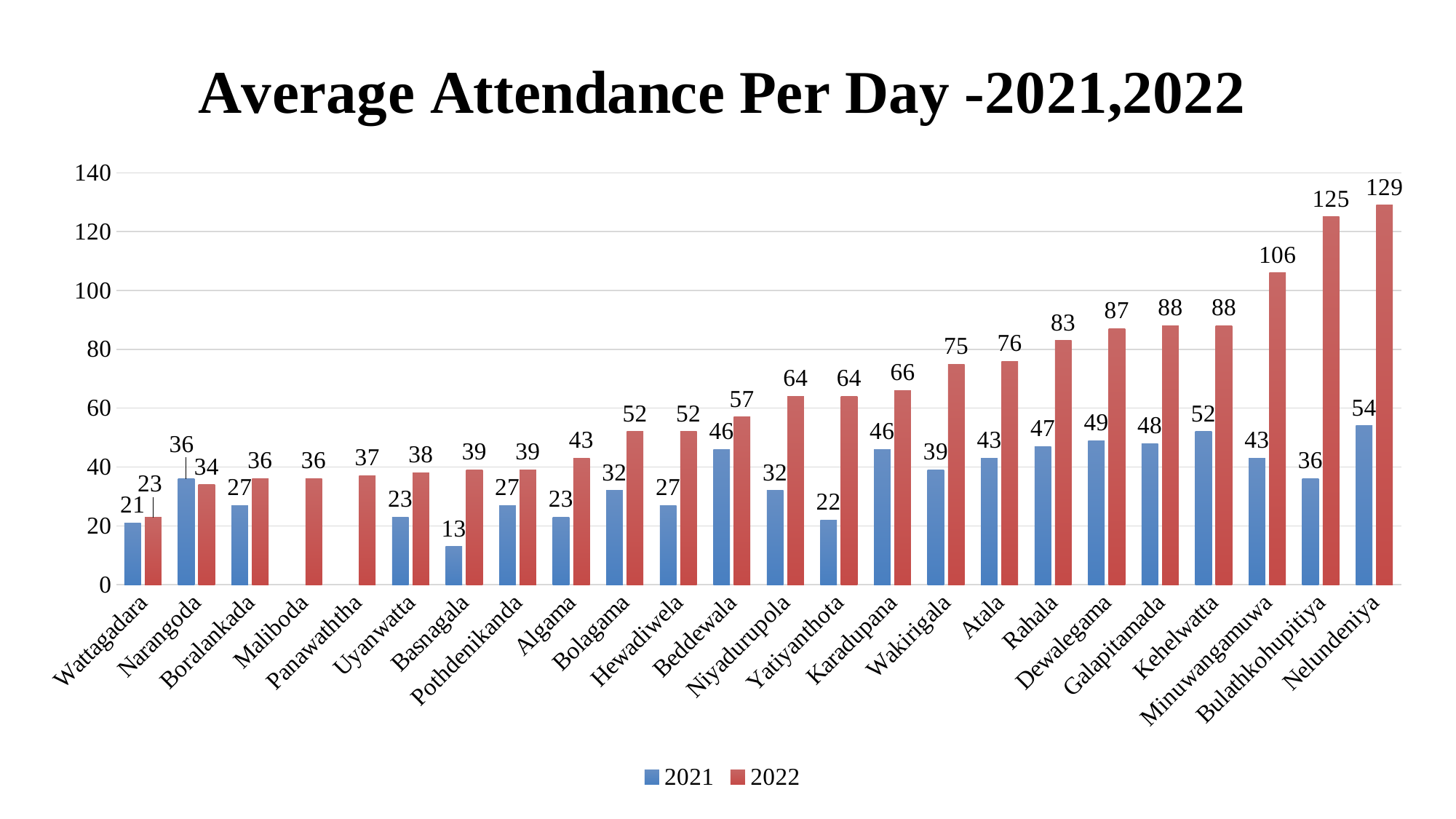
How many categories are shown on the x axis? 24 Which category has the lowest 2021 value? Basnagala What is the 2021 value for Basnagala? 13 What is the title of the chart? Average Attendance Per Day -2021,2022 What kind of chart is shown on the slide? bar chart What is the 2022 value for Minuwangamuwa? 106 Is the 2022 value for Rahala greater or less than 80? greater How many series does the legend list? 2 What is the difference between the 2022 and 2021 values for Bulathkohupitiya? 89 Which category has the highest 2022 value? Nelundeniya What is the 2022 value for Nelundeniya? 129 Which is larger for Narangoda, the 2021 value or the 2022 value? 2021